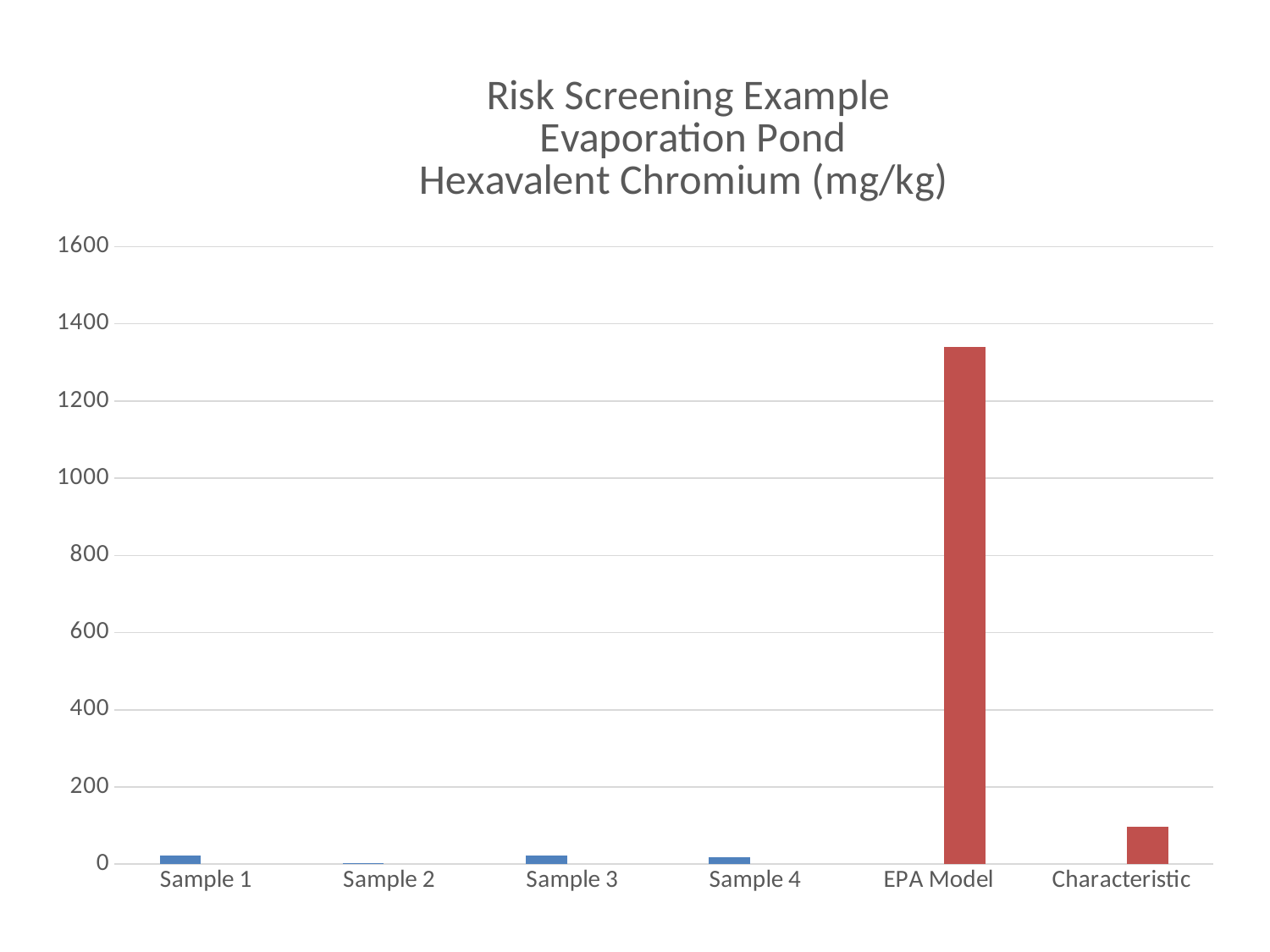
Which is larger, the value for Characteristic or the value for Sample 1? Characteristic Which is larger, the value for EPA Model or the value for Characteristic? EPA Model What kind of chart is shown on the slide? bar chart Is the value for EPA Model greater or less than 1200? greater Is the value for Sample 3 greater or less than 200? less Is the value for Characteristic greater or less than 200? less Which category has the highest value? EPA Model What unit is given in the chart title for hexavalent chromium? mg/kg Which category has the lowest value? Sample 2 How many categories are plotted on the x axis? 6 What colour are the bars for EPA Model and Characteristic? red